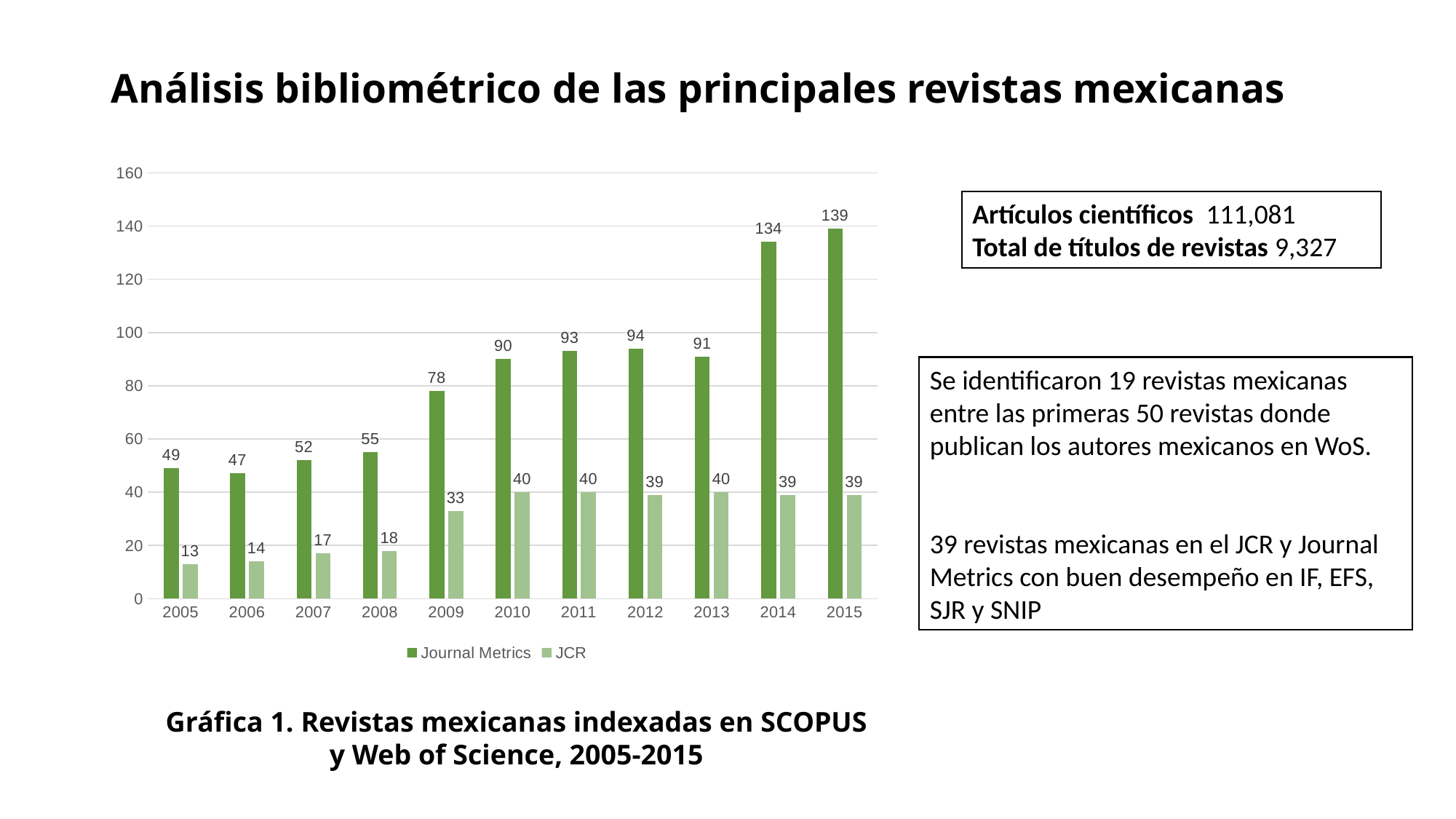
What is the Journal Metrics value for 2006? 47 What is the difference between the Journal Metrics values for 2014 and 2013? 43 What is the caption of the chart? Gráfica 1. Revistas mexicanas indexadas en SCOPUS y Web of Science, 2005-2015 What kind of chart is shown on the slide? Bar chart Which year has the lowest JCR value? 2005 How many series does the legend list? 2 Which is larger, the JCR value for 2008 or the JCR value for 2007? 2008 What is the JCR value for 2009? 33 Which year has the highest Journal Metrics value? 2015 What is the Journal Metrics value for 2015? 139 Is the Journal Metrics value for 2014 greater or less than 120? greater How many years are shown on the x axis? 11